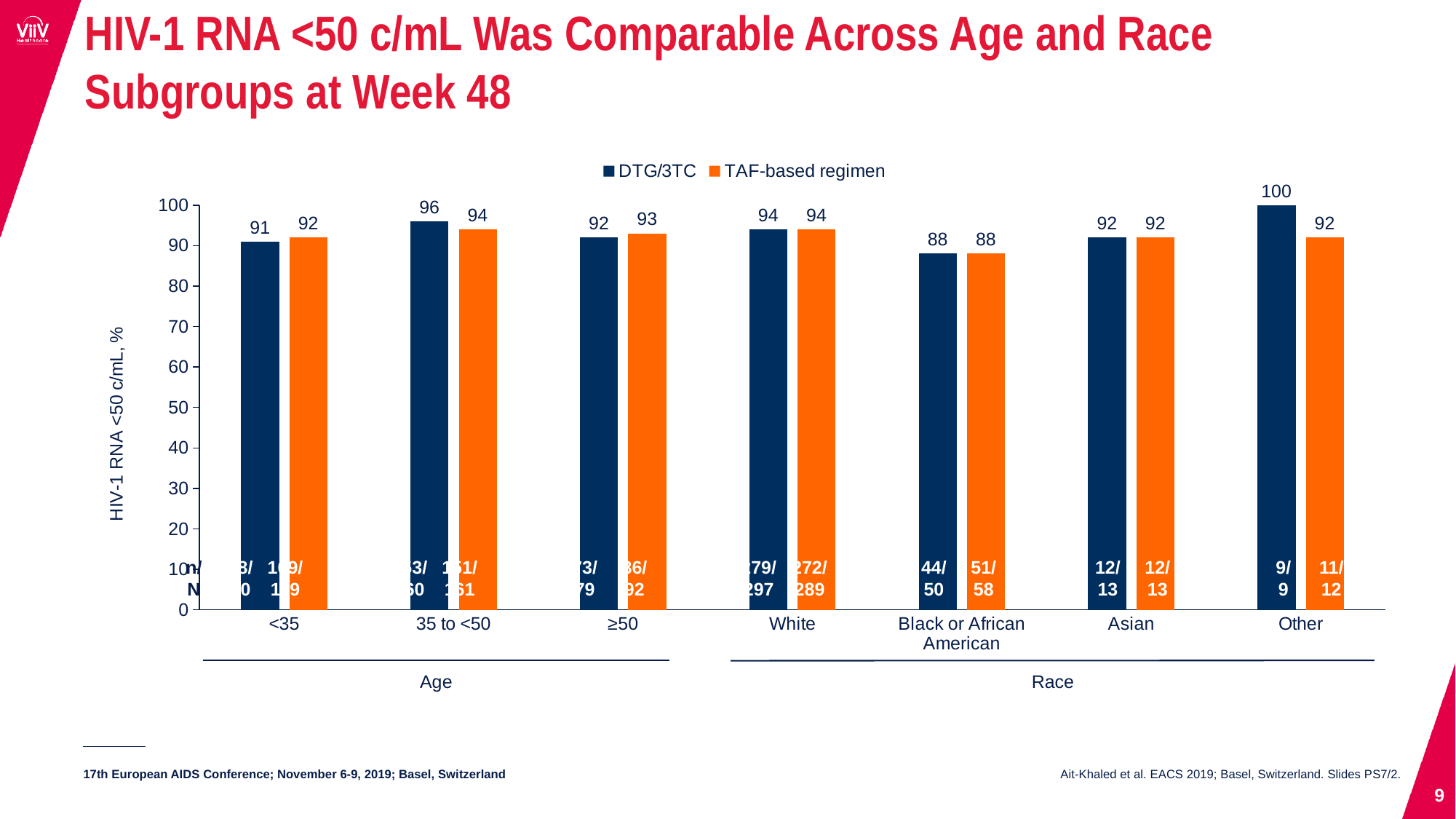
What kind of chart is shown on the slide? bar chart What is the value for DTG/3TC in the Other race subgroup? 100 Which subgroup has the highest value for DTG/3TC? Other In the <35 age subgroup, which series has the larger value, DTG/3TC or the TAF-based regimen? TAF-based regimen What is the label of the y axis? HIV-1 RNA <50 c/mL, % What is the value for DTG/3TC in the 35 to <50 age subgroup? 96 Is the value for DTG/3TC in the Black or African American subgroup greater or less than 90? less How many subgroups are shown on the x axis of the chart? 7 What is the difference between the DTG/3TC and TAF-based regimen values in the Other subgroup? 8 How many series does the legend list? 2 What is the value for the TAF-based regimen in the ≥50 age subgroup? 93 Which subgroup has the lowest value for the TAF-based regimen? Black or African American